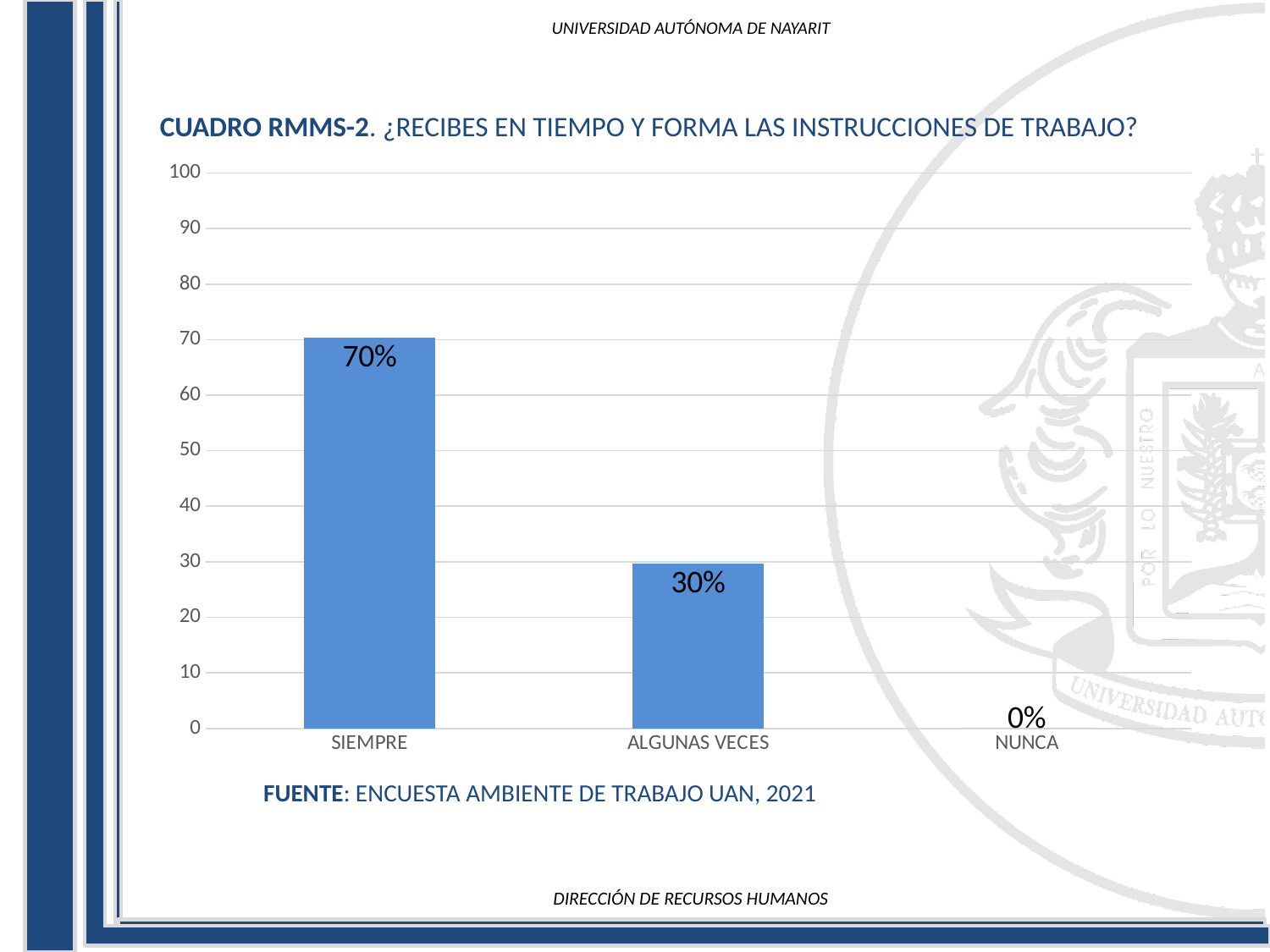
What kind of chart is shown on the slide? bar chart What is the difference between the values for SIEMPRE and ALGUNAS VECES? 40% Which category has the highest value? SIEMPRE Do the values rise or fall from left to right along the x axis? fall What is the value for NUNCA? 0% What is the value for ALGUNAS VECES? 30% Is the value for ALGUNAS VECES greater or less than 50? less How many categories are shown on the x axis? 3 What source is cited below the chart? ENCUESTA AMBIENTE DE TRABAJO UAN, 2021 What is the value for SIEMPRE? 70% Which category has the lowest value? NUNCA Which is larger, the value for SIEMPRE or the value for ALGUNAS VECES? SIEMPRE